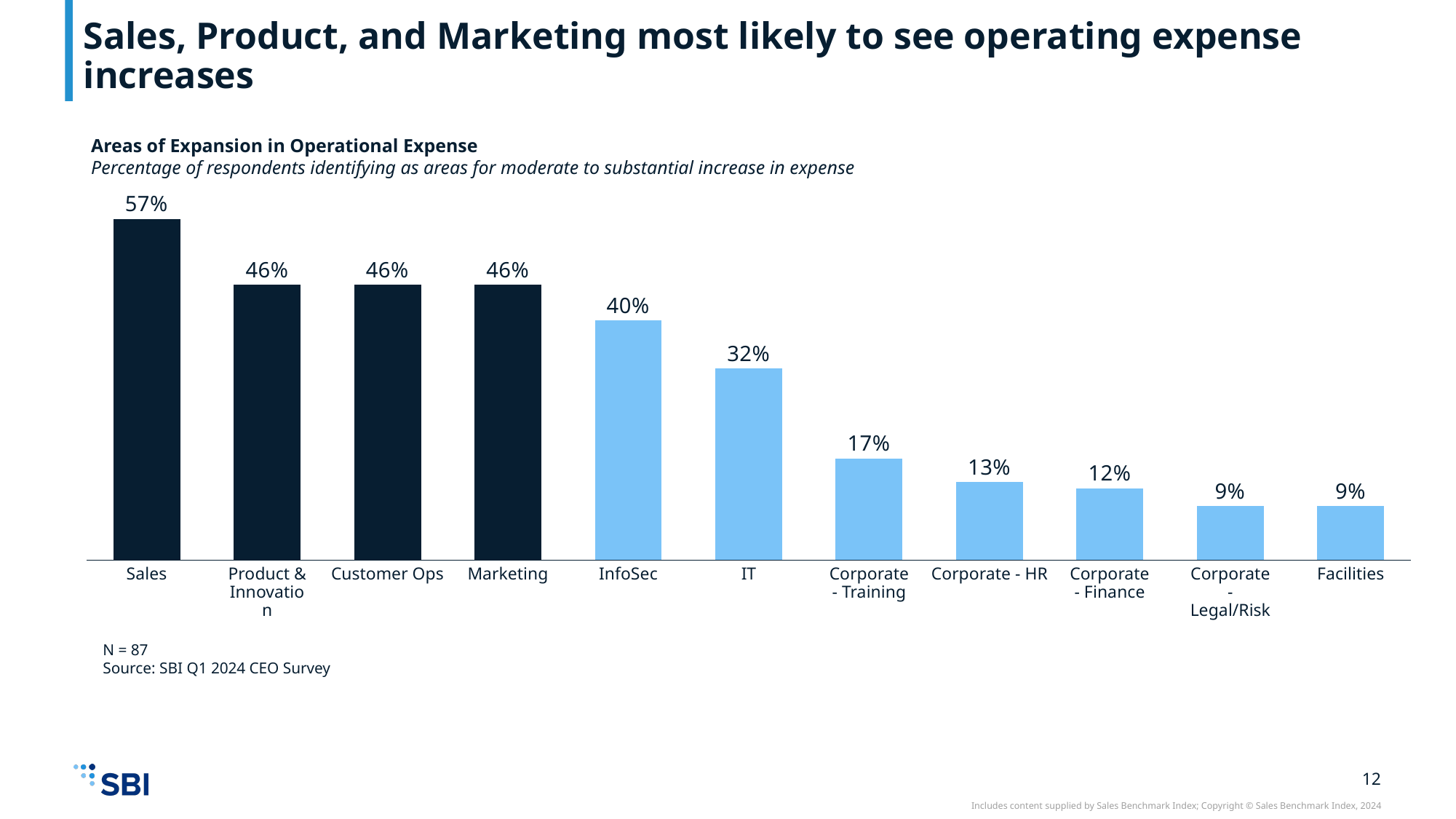
What kind of chart is shown on the slide? Bar chart What is the lowest value shown in the chart? 9% What is the title of the chart? Areas of Expansion in Operational Expense What is the difference between the values for InfoSec and Corporate - HR? 27% What is the difference between the values for Sales and IT? 25% What is the value shown for Corporate - Finance? 12% What is the value shown for InfoSec? 40% Which category has the highest value in the chart? Sales How many categories are shown in the chart? 11 What percentage of respondents identified Sales as an area for moderate to substantial increase in expense? 57% What is the value shown for Corporate - Training? 17% Which is larger, the value for IT or the value for Corporate - Training? IT